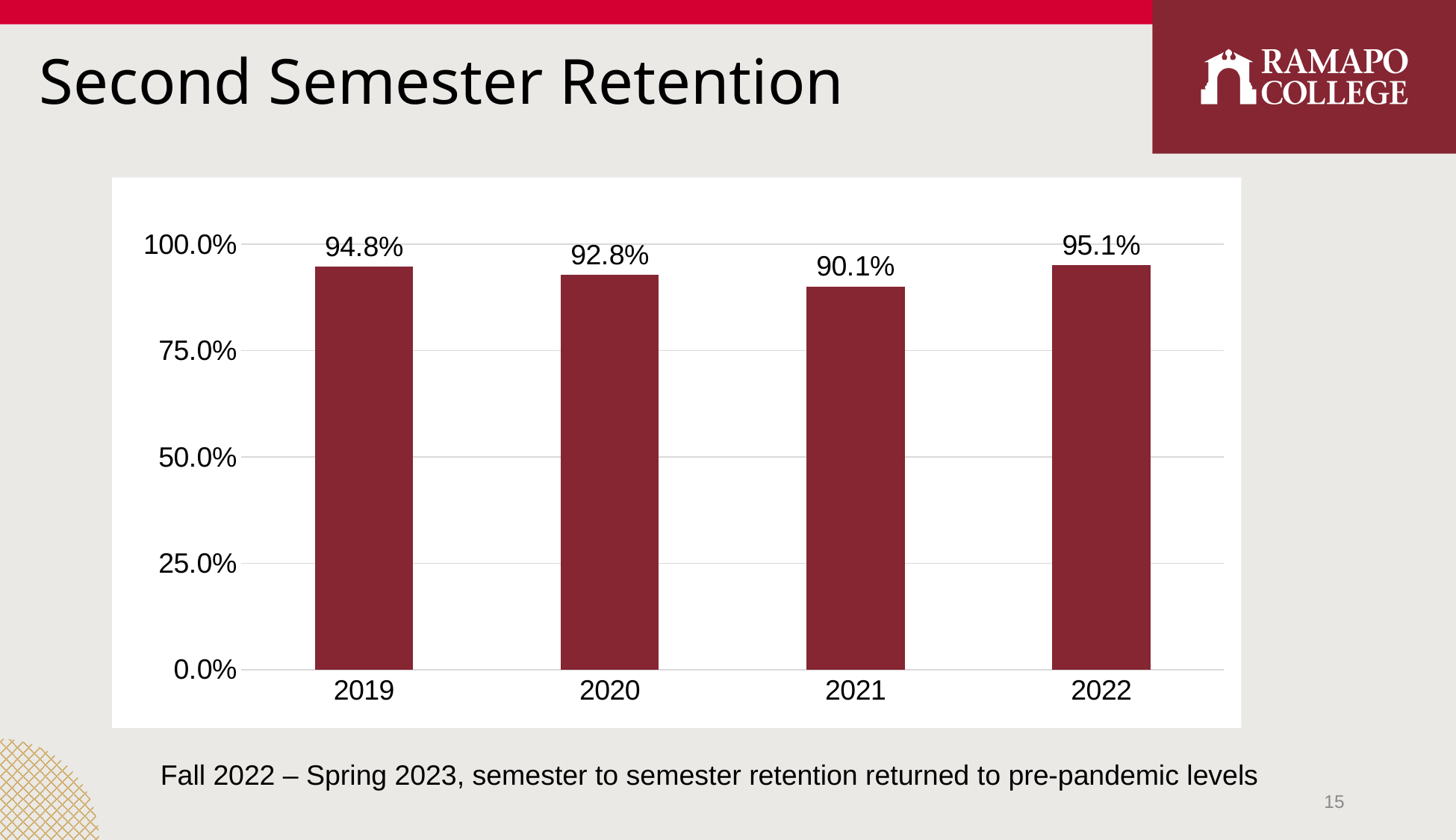
Which year has a higher retention rate, 2020 or 2021? 2020 What is the title of the slide containing the chart? Second Semester Retention What is the second semester retention rate for 2022? 95.1% What is the second semester retention rate for 2019? 94.8% Which year has the lowest second semester retention rate? 2021 What is the difference in retention rate between 2019 and 2020? 2.0% What kind of chart is shown on the slide? Bar chart Is the retention rate for 2021 greater or less than 75.0%? greater What is the second semester retention rate for 2021? 90.1% What is the difference in retention rate between 2022 and 2021? 5.0% Which year has the highest second semester retention rate? 2022 How many years are shown on the chart? 4